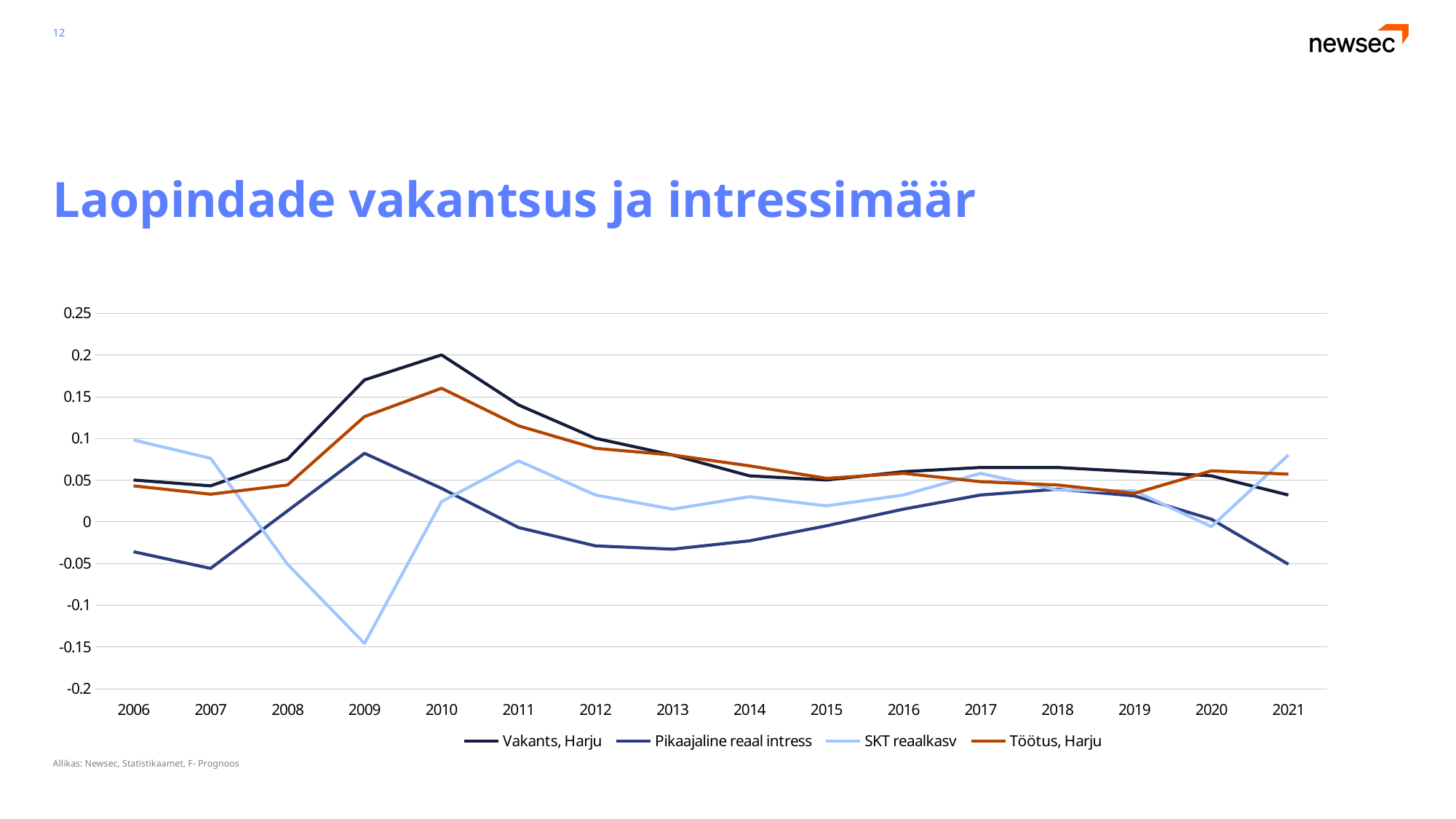
In 2009, which is larger: Vakants, Harju or SKT reaalkasv? Vakants, Harju In which year does the SKT reaalkasv series reach its lowest value? 2009 Is the value for SKT reaalkasv in 2009 greater or less than -0.1? less Is the value for Vakants, Harju in 2009 greater or less than 0.15? greater How many years are shown on the x axis? 16 In which year does the Töötus, Harju series reach its highest value? 2010 What kind of chart is shown on the slide? line chart How many series does the legend list? 4 In which year does the Vakants, Harju series reach its highest value? 2010 Which series is drawn in orange? Töötus, Harju What is the title of the chart? Laopindade vakantsus ja intressimäär Does the Vakants, Harju series rise or fall between 2010 and 2015? fall